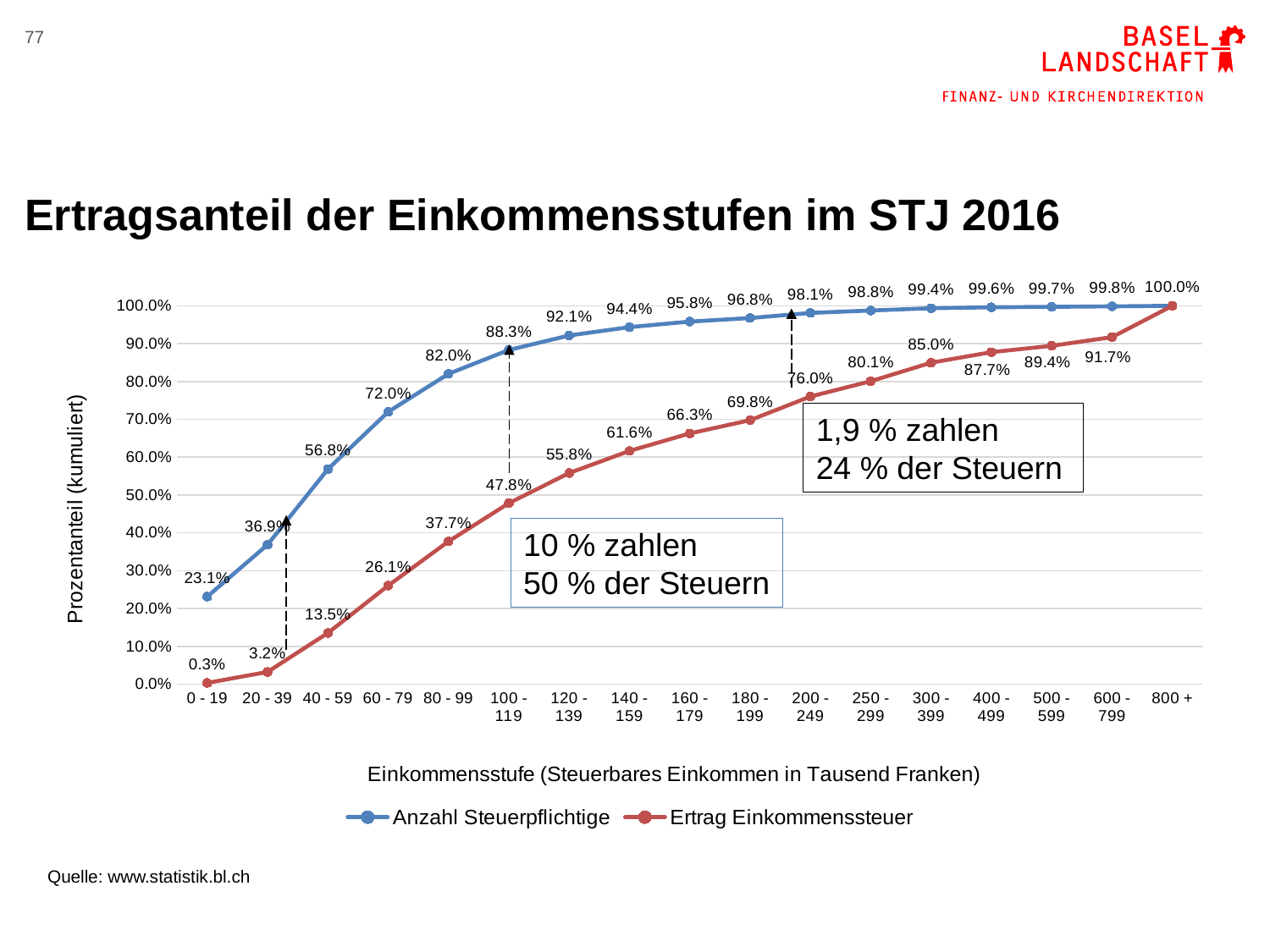
What is the value of Ertrag Einkommenssteuer for the income category 0 - 19? 0.3% How many income categories are shown on the x axis? 17 What is the title of the chart? Ertragsanteil der Einkommensstufen im STJ 2016 Which income category has the lowest value for Anzahl Steuerpflichtige? 0 - 19 What type of chart is shown on the slide? line chart Do the values of Ertrag Einkommenssteuer rise or fall along the x axis? rise What is the value of Ertrag Einkommenssteuer for the income category 100 - 119? 47.8% For the income category 120 - 139, which series has the larger value, Anzahl Steuerpflichtige or Ertrag Einkommenssteuer? Anzahl Steuerpflichtige What is the value of Anzahl Steuerpflichtige for the income category 200 - 249? 98.1% How many series does the legend list? 2 What is the difference between Anzahl Steuerpflichtige and Ertrag Einkommenssteuer for the income category 80 - 99? 44.3% What is the value of Anzahl Steuerpflichtige for the income category 40 - 59? 56.8%